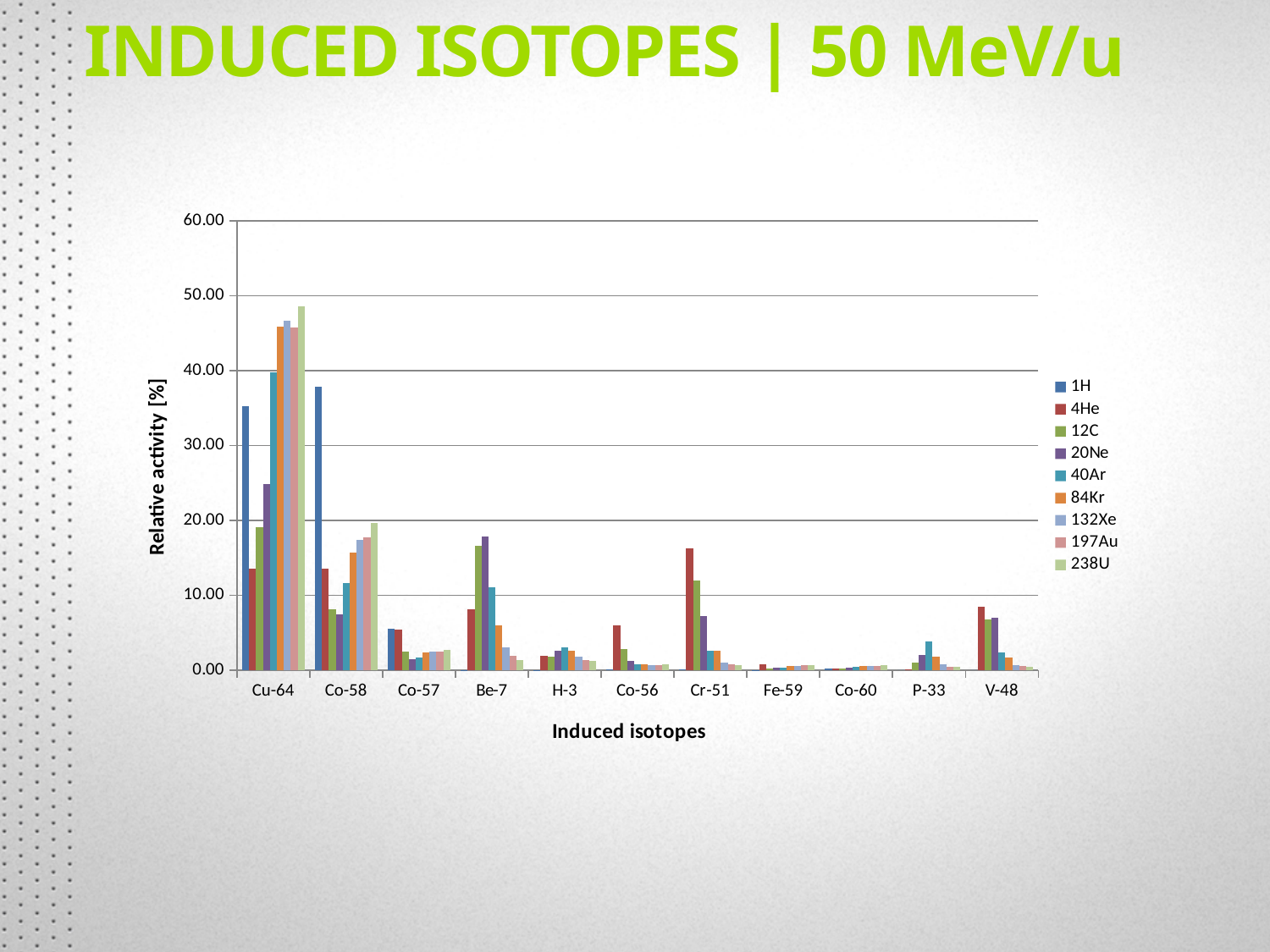
For the 1H series, which isotope has the highest value? Co-58 How many series does the legend list? 9 How many induced isotopes (categories) are shown on the x axis? 11 Is the value for 238U at Cu-64 greater or less than 40? greater Which series has the highest value at Cr-51? 4He Which series has the highest value at Cu-64? 238U Is the value for 1H at Cu-64 greater or less than 30? greater What is the title of the y axis? Relative activity [%] Is the value for 4He at Cr-51 greater or less than 10? greater What kind of chart is shown on the slide? bar chart Which is larger: the 4He value at Cr-51 or the 12C value at Cr-51? 4He at Cr-51